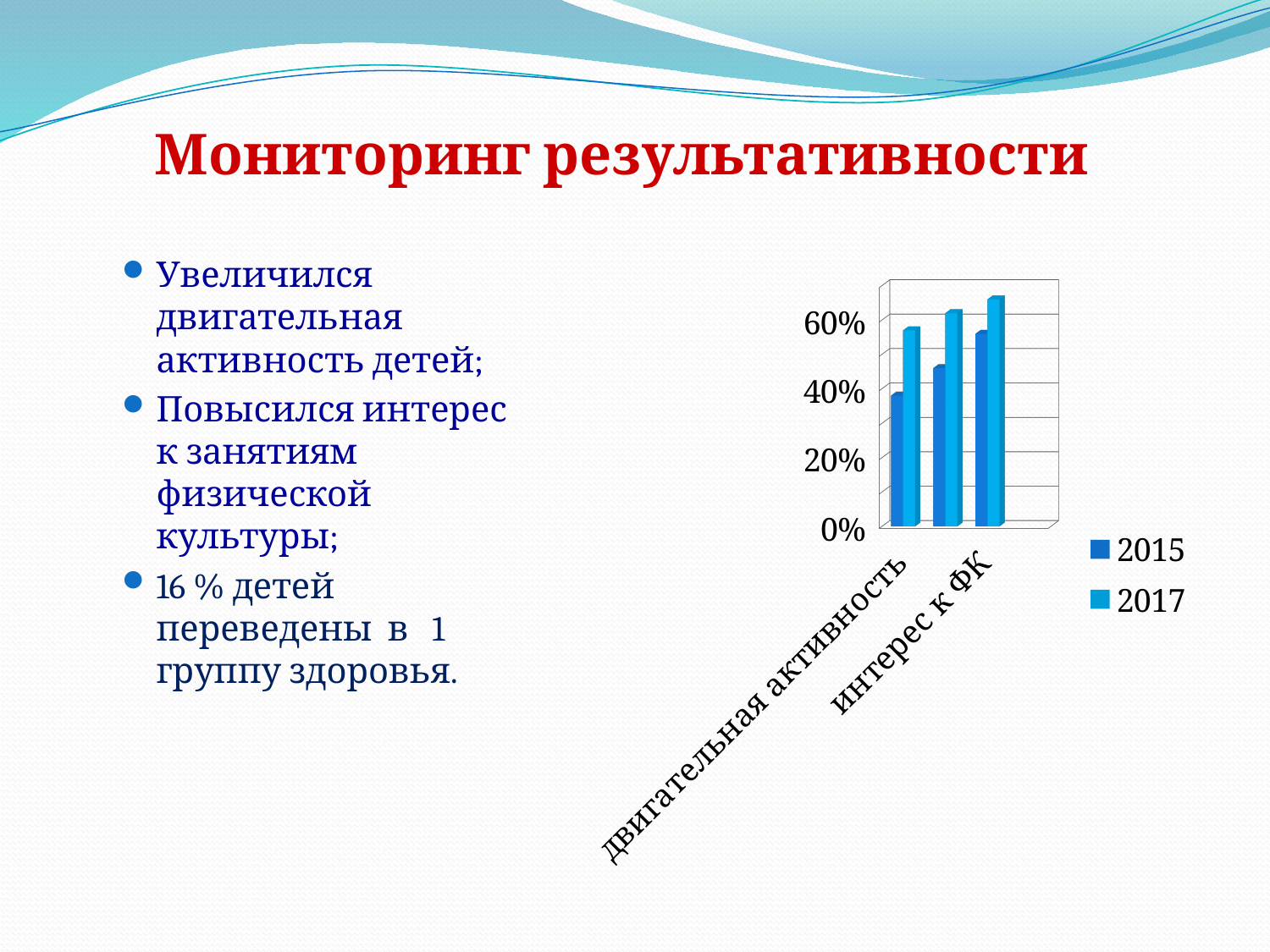
What is the highest value shown on the chart's vertical axis? 60% Is the 2015 value for двигательная активность greater or less than 60%? less How many series does the chart legend list? 2 Is the 2015 value for интерес к ФК greater or less than 40%? greater What kind of chart is shown on the slide? bar chart Is the 2015 value for интерес к ФК greater or less than 60%? less For двигательная активность, which is larger: the 2015 value or the 2017 value? 2017 Do the values rise or fall from 2015 to 2017 for each category in the chart? rise Which years are listed in the chart legend? 2015 and 2017 For интерес к ФК, which is larger: the 2015 value or the 2017 value? 2017